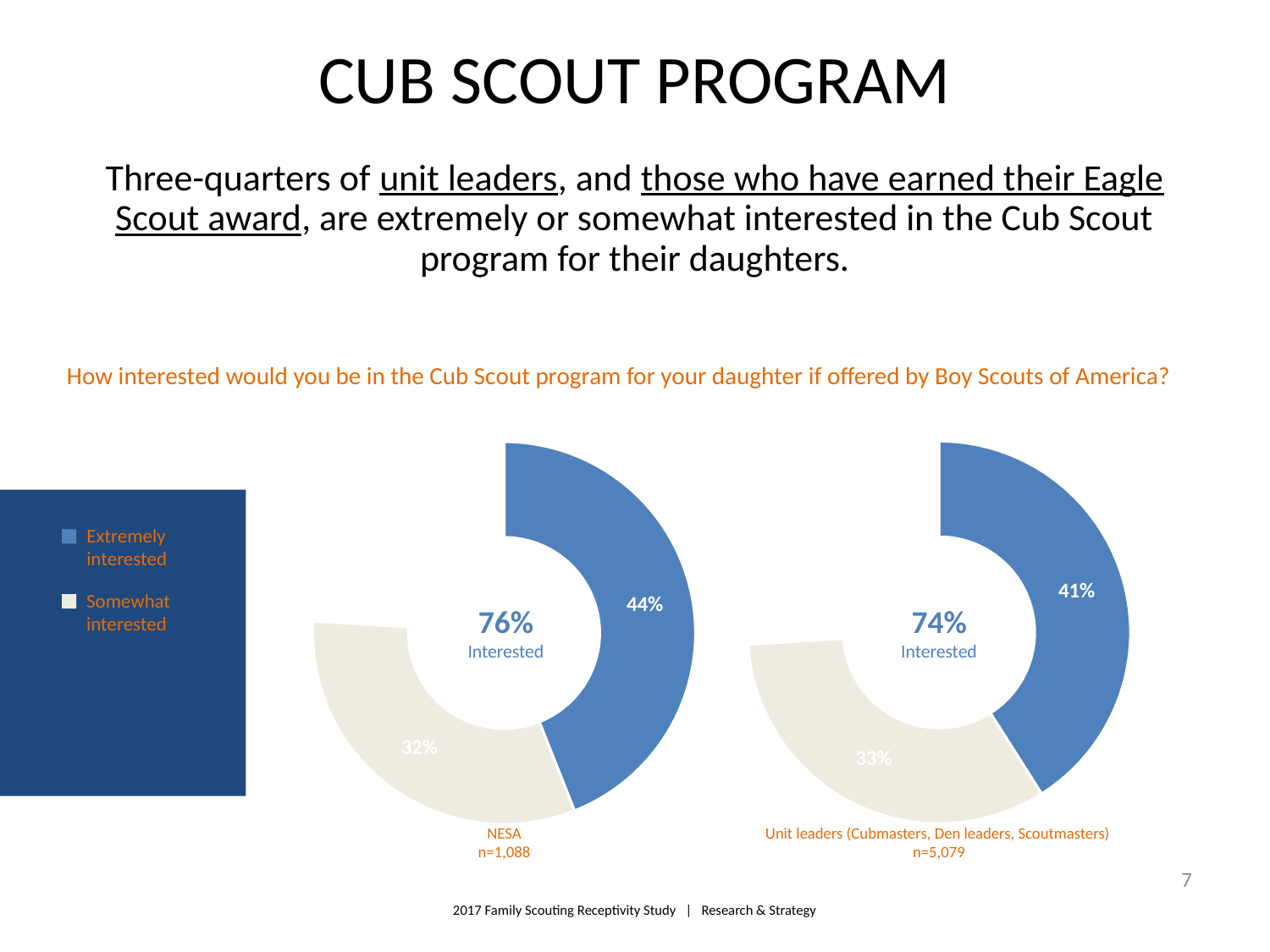
How many categories does the legend list? 2 What is the sample size (n) shown for the Unit leaders chart? n=5,079 In the NESA chart, what is the difference between the extremely interested and somewhat interested percentages? 12% Which colour represents 'Extremely interested' in the charts? Blue In the Unit leaders chart, what percentage are extremely interested? 41% In the Unit leaders chart, what total percentage is shown as interested in the centre? 74% In the NESA chart, what total percentage is shown as interested in the centre? 76% In the NESA chart, what percentage are somewhat interested? 32% In the Unit leaders chart, what percentage are somewhat interested? 33% In the NESA chart, what percentage are extremely interested? 44% Which chart has the larger extremely interested percentage, NESA or Unit leaders? NESA What kind of chart is used to show the NESA results? Donut (pie) chart